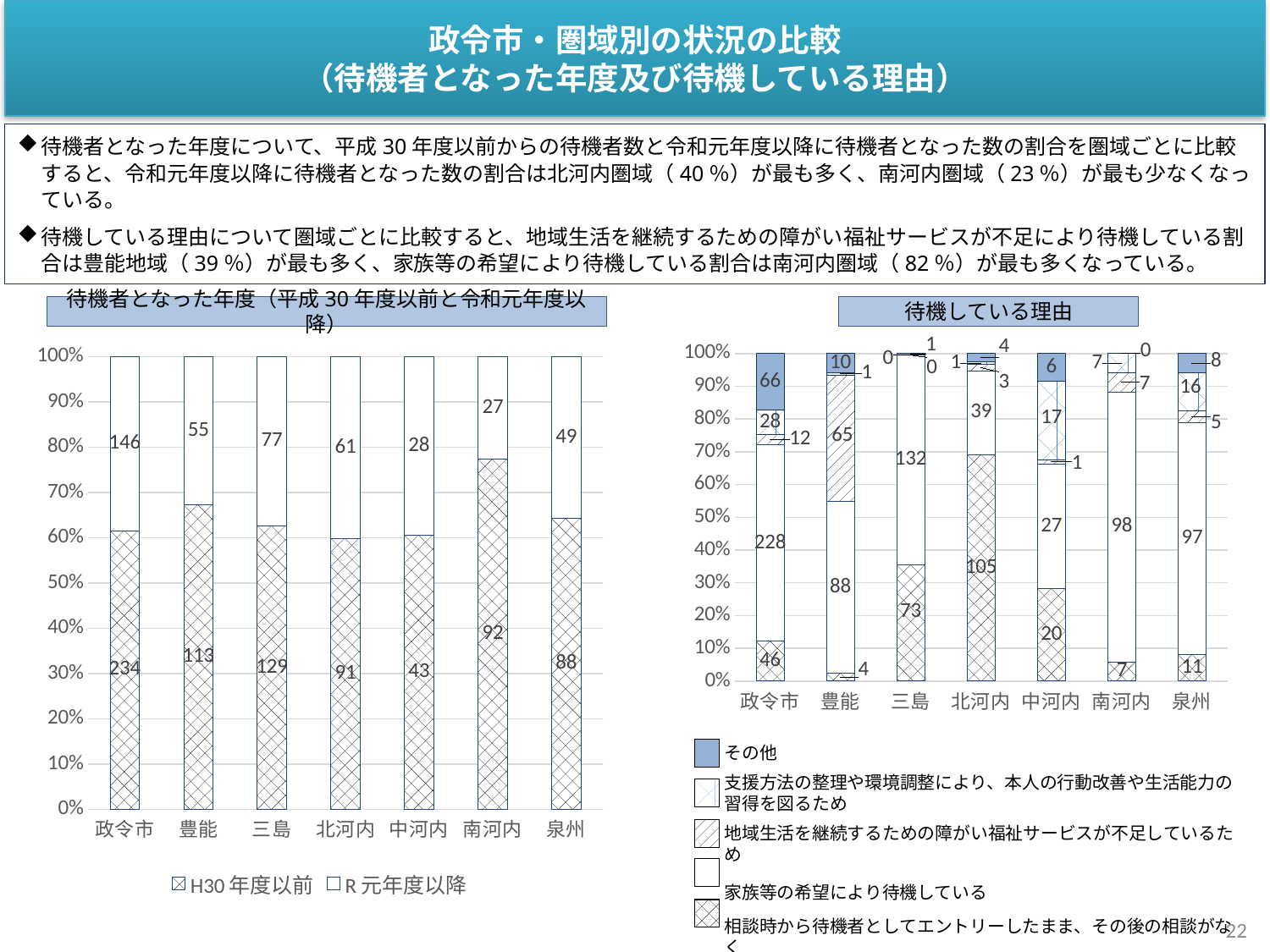
In the right chart (待機している理由), how many series does the legend list? 5 In the right chart (待機している理由), what is the value for 相談時から待機者としてエントリーしたまま、その後の相談がなく for 北河内? 105 In the left chart (待機者となった年度), which category has the lowest R元年度以降 value? 南河内 In the left chart (待機者となった年度), how many series does the legend list? 2 In the left chart (待機者となった年度), what is the total of the two values for 政令市? 380 In the left chart (待機者となった年度), what is the value for R元年度以降 for 南河内? 27 In the left chart (待機者となった年度), which category has the highest H30年度以前 value? 政令市 In the left chart (待機者となった年度), how many categories are shown on the x axis? 7 In the left chart (待機者となった年度), what is the value for H30年度以前 for 政令市? 234 In the right chart (待機している理由), what is the value for 家族等の希望により待機している for 政令市? 228 In the left chart (待機者となった年度), what is the difference between the H30年度以前 and R元年度以降 values for 豊能? 58 What kind of chart is the right chart (待機している理由)? Stacked bar chart